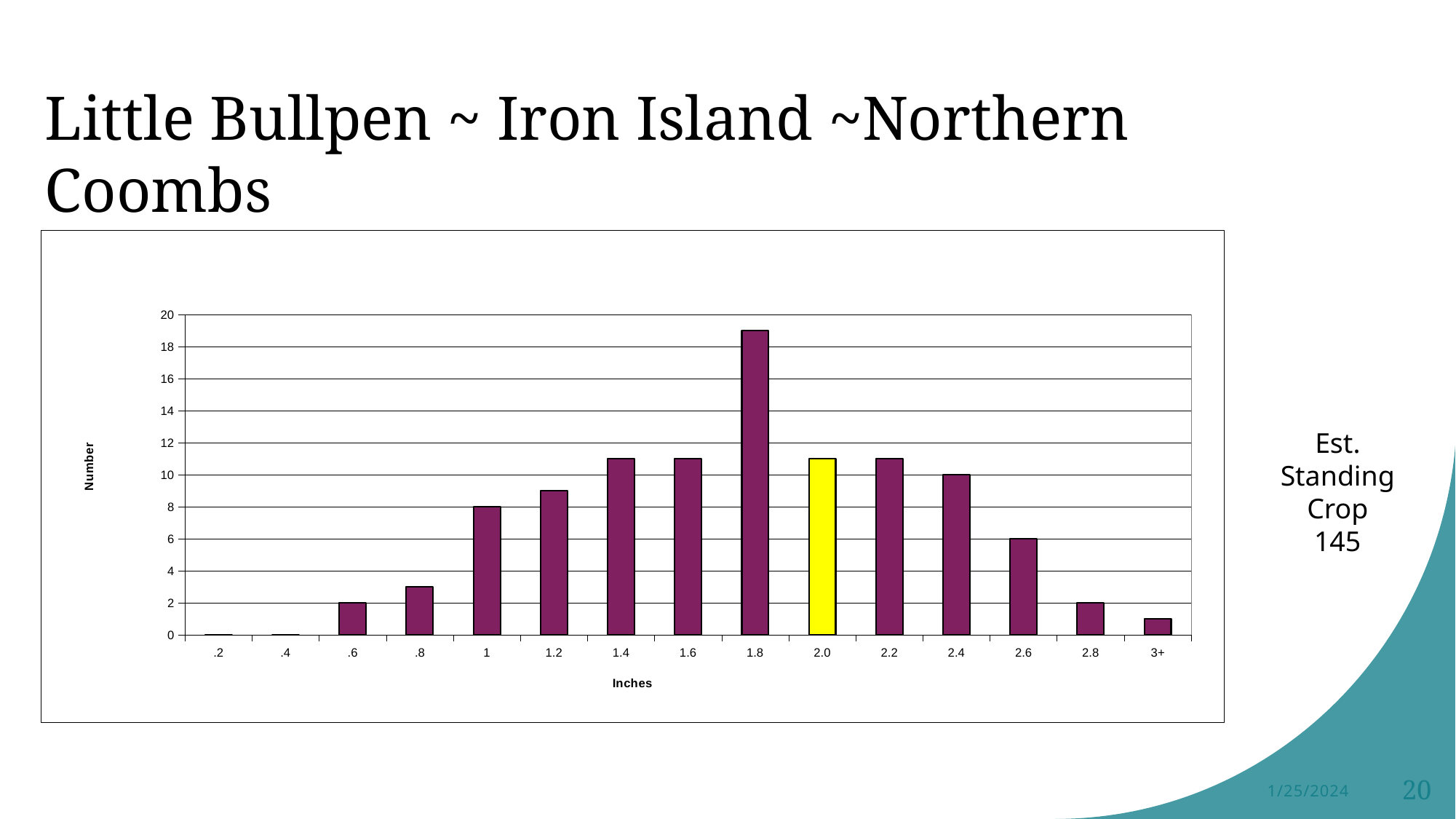
What is the number for the .6 inch category? 2 What is the number for the 1 inch category? 8 What is the number for the 2.4 inch category? 10 What is the difference between the number for 1 inch and the number for 2.6 inches? 2 Which inch category has the highest number? 1.8 Is the value for the 1.4 inch category greater or less than 10? greater Is the value for the 3+ inch category greater or less than 2? less What is the number for the 2.6 inch category? 6 Which inch category is shown with a yellow bar? 2.0 Is the value for the 1.8 inch category greater or less than 18? greater What type of chart is shown on the slide? bar chart How many inch categories are shown on the x axis? 15